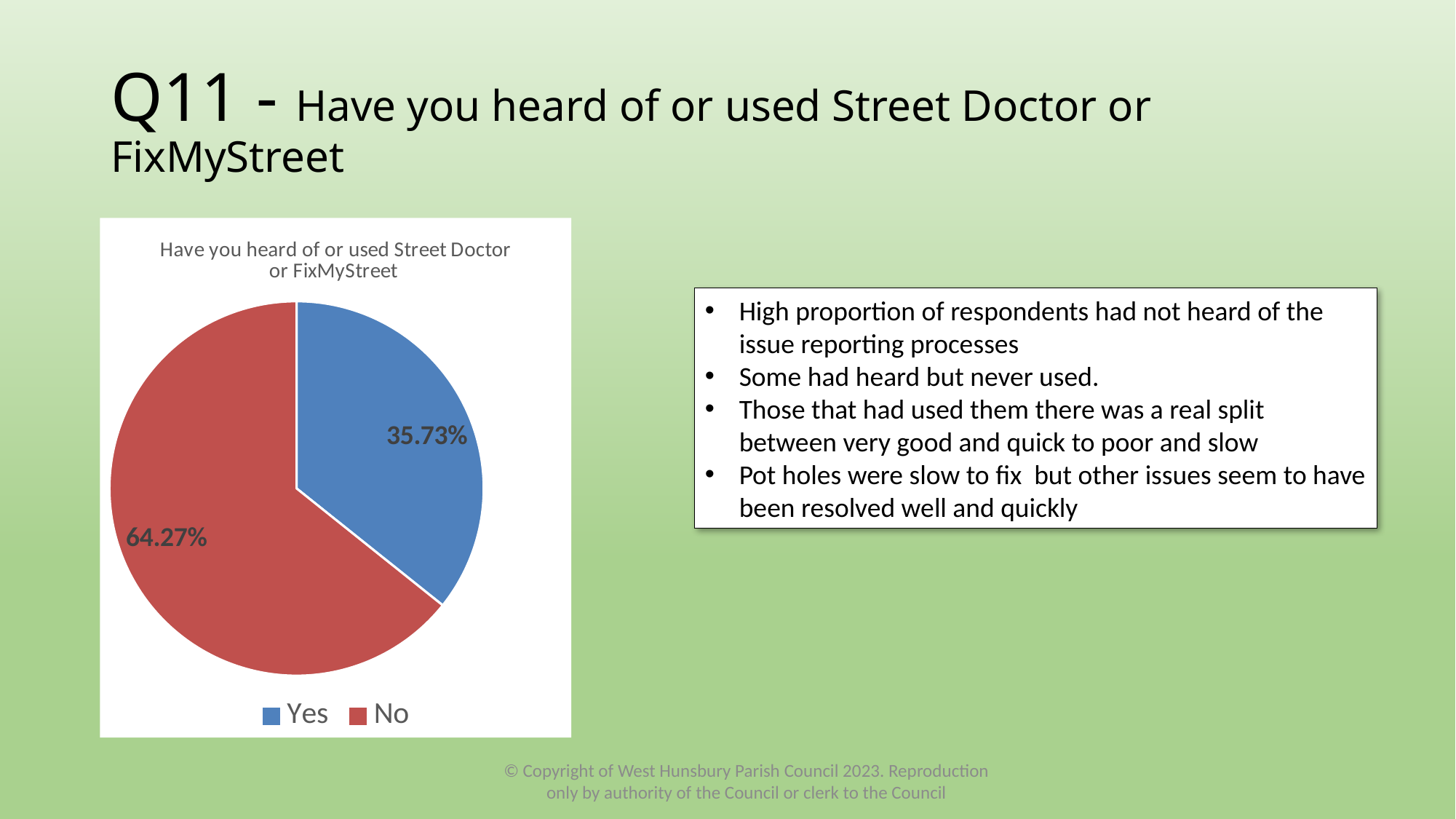
What kind of chart is shown on the slide? Pie chart Which slice of the pie is the smallest? Yes How many slices does the pie chart have? 2 What is the difference in percentage points between the "No" and "Yes" slices? 28.54 Which is larger, the "Yes" slice or the "No" slice? No Which slice of the pie is the largest? No What is the title of the chart? Have you heard of or used Street Doctor or FixMyStreet What share of the pie is labelled "No"? 64.27% What share of the pie is labelled "Yes"? 35.73% How many entries does the legend list? 2 What colour is the "No" slice of the pie? Red